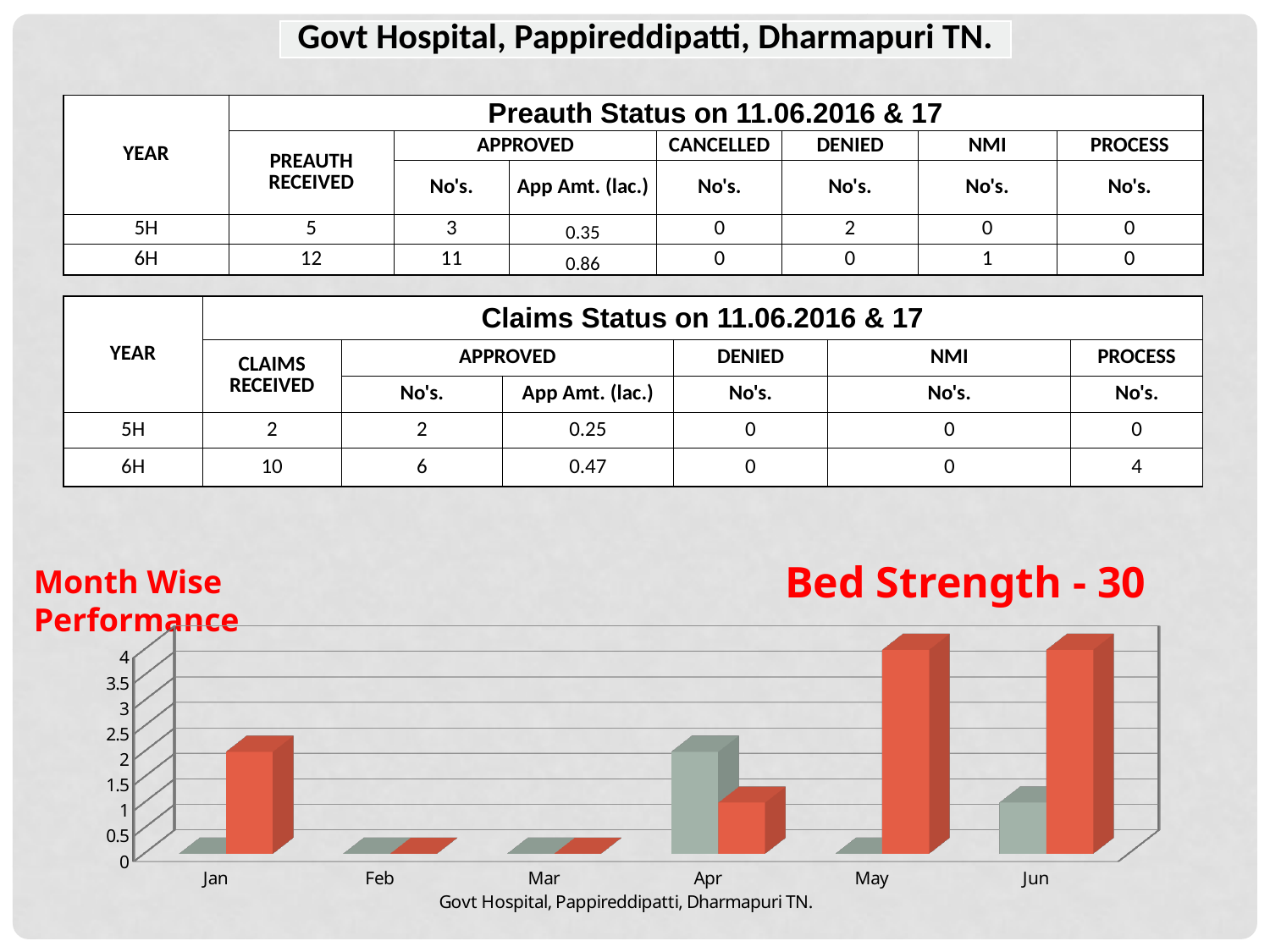
How many months are shown on the x axis of the Month Wise Performance chart? 6 In the Month Wise Performance chart, is the red bar for May greater or less than 3? greater In the Month Wise Performance chart, which red bar is taller: Jan or Apr? Jan In the Month Wise Performance chart, for Jun, which is taller: the grey bar or the red bar? the red bar In the Month Wise Performance chart, is the red bar for Jan greater or less than 1? greater In the Month Wise Performance chart, is the red bar for Apr greater or less than 2? less In the Month Wise Performance chart, which month has the tallest grey bar? Apr What is the highest value shown on the vertical axis of the Month Wise Performance chart? 4 In the Month Wise Performance chart, for Apr, which is taller: the grey bar or the red bar? the grey bar What kind of chart is shown under the heading 'Month Wise Performance'? bar chart